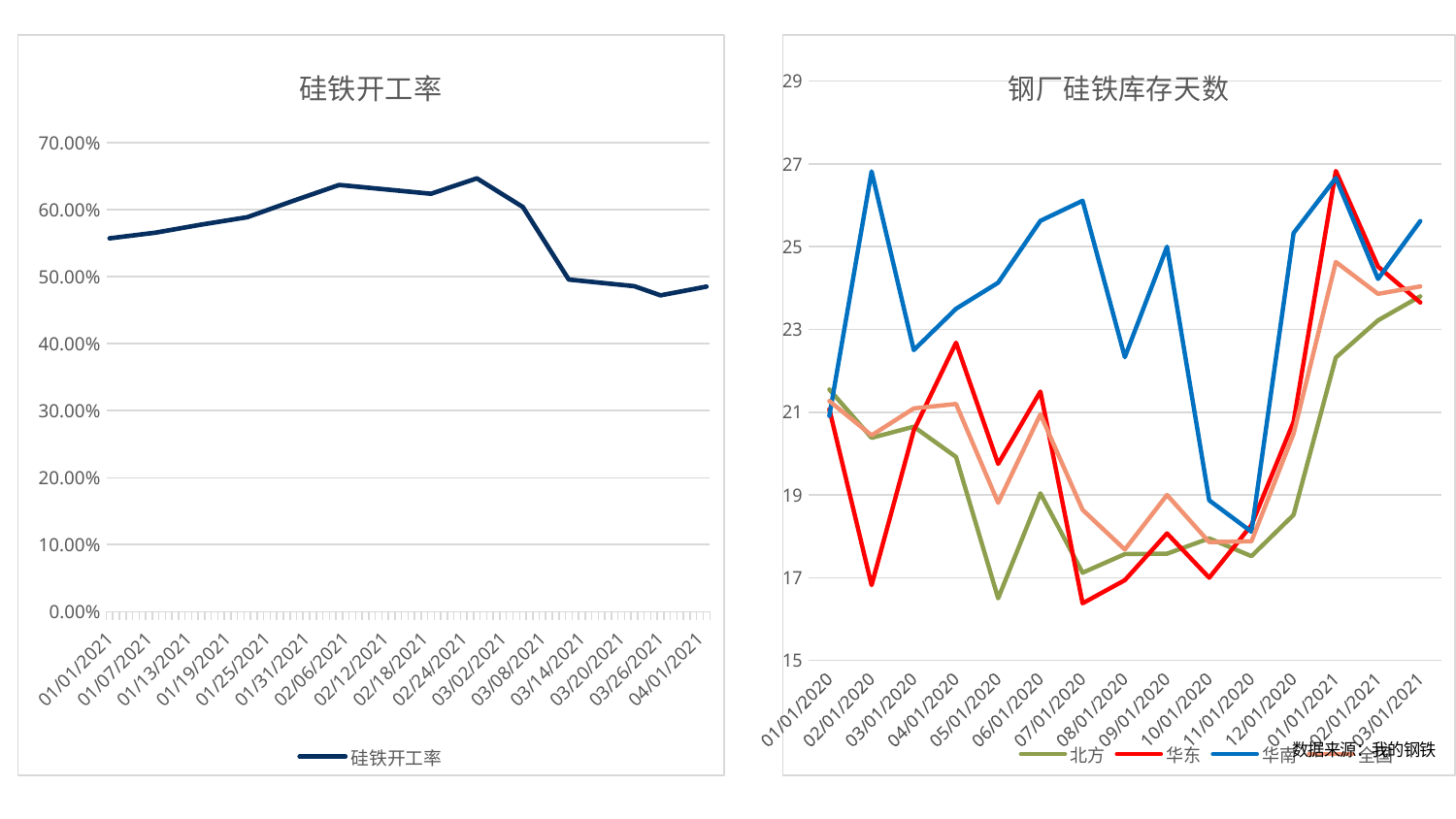
In the 钢厂硅铁库存天数 chart, is the 华南 value at 02/01/2020 greater or less than 25? greater In the 硅铁开工率 chart, is the value at 04/01/2021 greater or less than 50.00%? less In the 硅铁开工率 chart, is the value at 02/24/2021 greater or less than 60.00%? greater How many series does the legend of the 硅铁开工率 chart on the left list? 1 In the 钢厂硅铁库存天数 chart, which series has the highest value at 02/01/2020? 华南 What kind of chart is the 硅铁开工率 chart on the left? line chart In the 钢厂硅铁库存天数 chart, which series has the lowest value at 05/01/2020? 北方 How many x-axis categories does the 钢厂硅铁库存天数 chart show? 15 How many series does the legend of the 钢厂硅铁库存天数 chart on the right list? 4 In the 硅铁开工率 chart, is the value at the end of the period (04/01/2021) higher or lower than at the start (01/01/2021)? lower